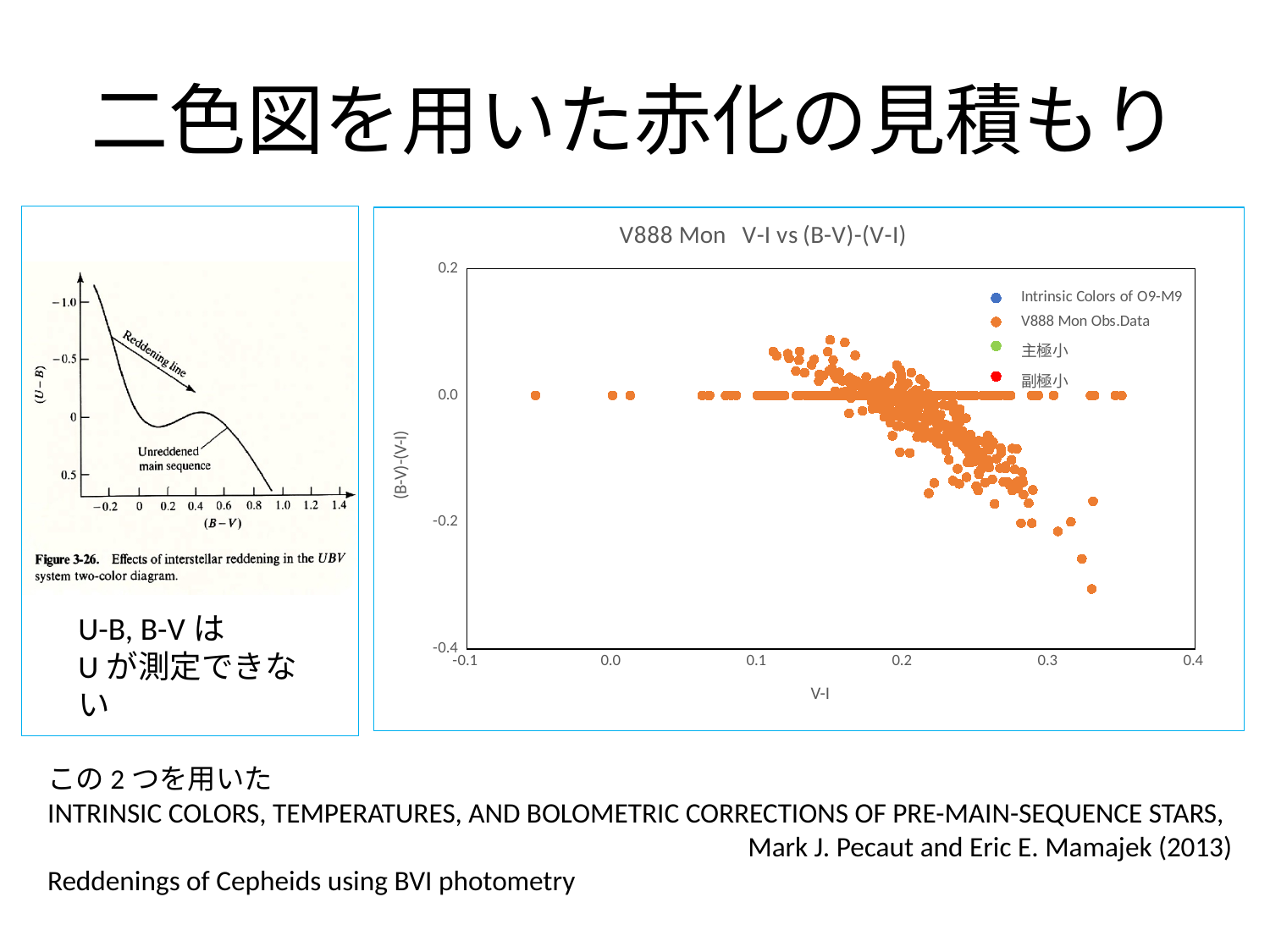
How many series does the legend of the "V888 Mon V-I vs (B-V)-(V-I)" chart list? 4 In the "V888 Mon V-I vs (B-V)-(V-I)" chart, is the V-I value of the leftmost plotted point greater or less than 0.0? less In the "V888 Mon V-I vs (B-V)-(V-I)" chart, is the largest V-I value among the plotted points greater or less than 0.4? less What kind of chart is the chart titled "V888 Mon V-I vs (B-V)-(V-I)"? scatter chart In the "V888 Mon V-I vs (B-V)-(V-I)" chart, is the lowest plotted (B-V)-(V-I) value greater or less than -0.2? less What is the label of the x axis of the "V888 Mon V-I vs (B-V)-(V-I)" chart? V-I What is the title of the scatter chart on the right of the slide? V888 Mon V-I vs (B-V)-(V-I) In the "V888 Mon V-I vs (B-V)-(V-I)" chart, do the V888 Mon Obs.Data points generally rise or fall in (B-V)-(V-I) as V-I increases beyond 0.2? fall